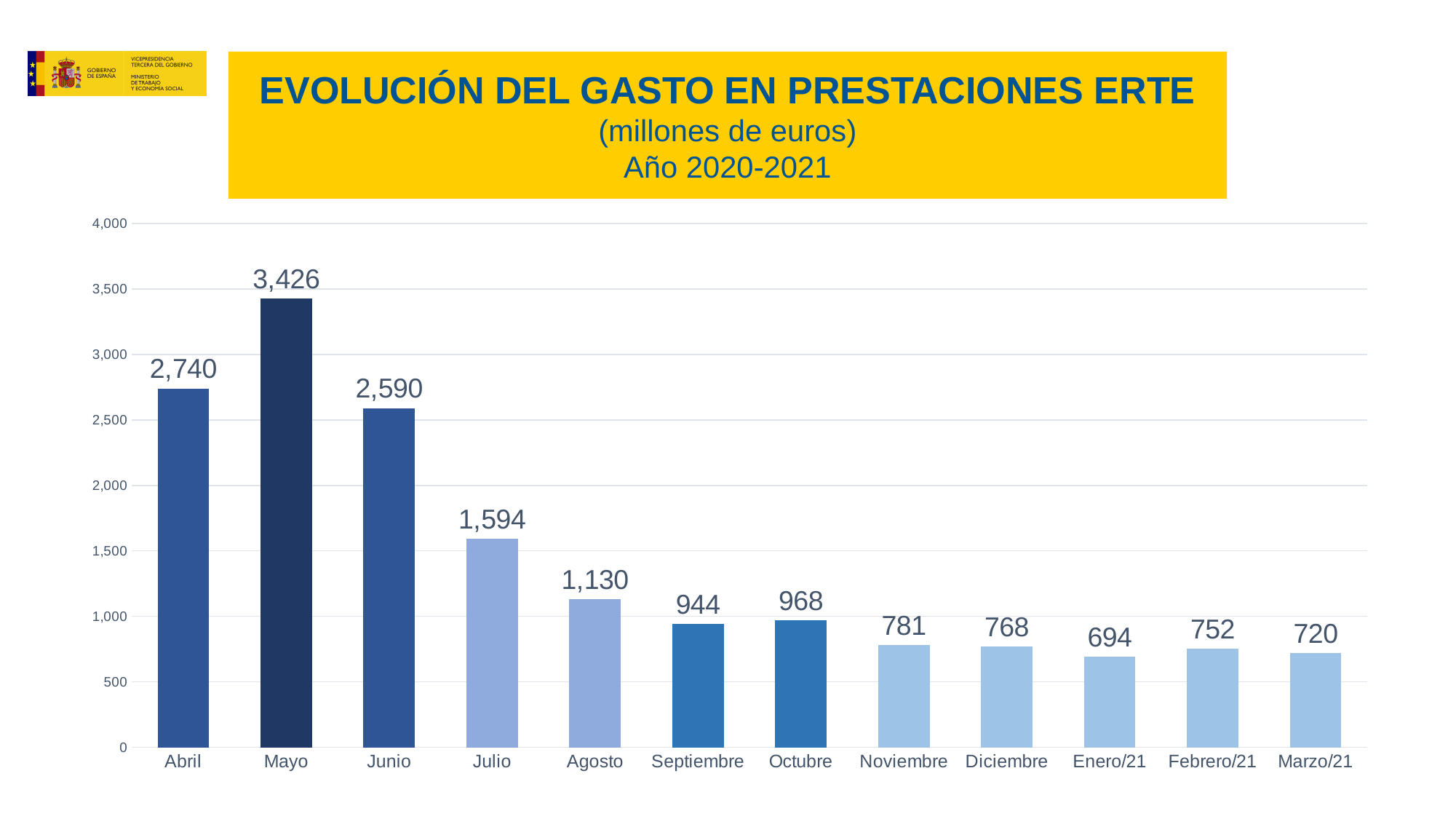
What is the value for Agosto? 1,130 What unit is stated in the chart title? millones de euros Do the values generally rise or fall from Mayo to Enero/21? fall Is the value for Julio greater or less than 1,500? greater Which is larger, the value for Septiembre or the value for Octubre? Octubre Which month has the lowest value? Enero/21 What is the value for Mayo? 3,426 What is the difference between the values for Mayo and Junio? 836 What is the value for Enero/21? 694 How many months are shown on the x axis? 12 Which month has the highest value? Mayo What kind of chart is shown on the slide? bar chart